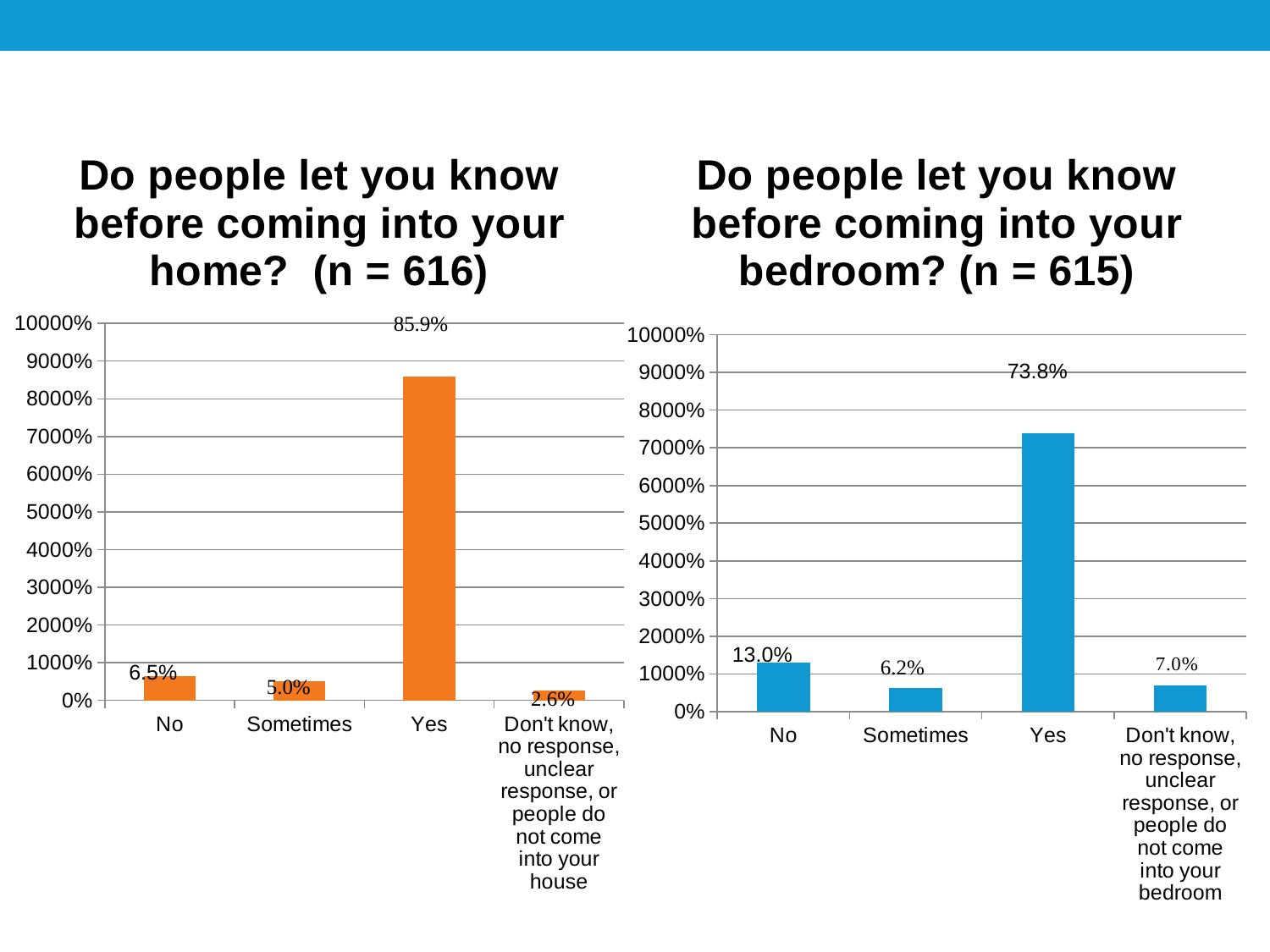
In the right chart (bedroom), what is the difference between the values for No and Sometimes? 6.8% Which is larger: the value for Yes in the home chart or the value for Yes in the bedroom chart? Yes in the home chart What kind of chart is the left chart (home)? Bar chart In the right chart (bedroom), which category has the highest value? Yes In the left chart (home), which category has the lowest value? Don't know, no response, unclear response, or people do not come into your house In the left chart (home), what is the difference between the values for Yes and No? 79.4% What colour are the bars in the right chart (bedroom)? Blue In the chart titled "Do people let you know before coming into your home?", what is the value for Yes? 85.9% In the left chart (home), what is the value for Sometimes? 5.0% In the chart titled "Do people let you know before coming into your bedroom?", what is the value for No? 13.0% In the right chart (bedroom), what is the value for Sometimes? 6.2% How many categories are shown on the x axis of the right chart (bedroom)? 4